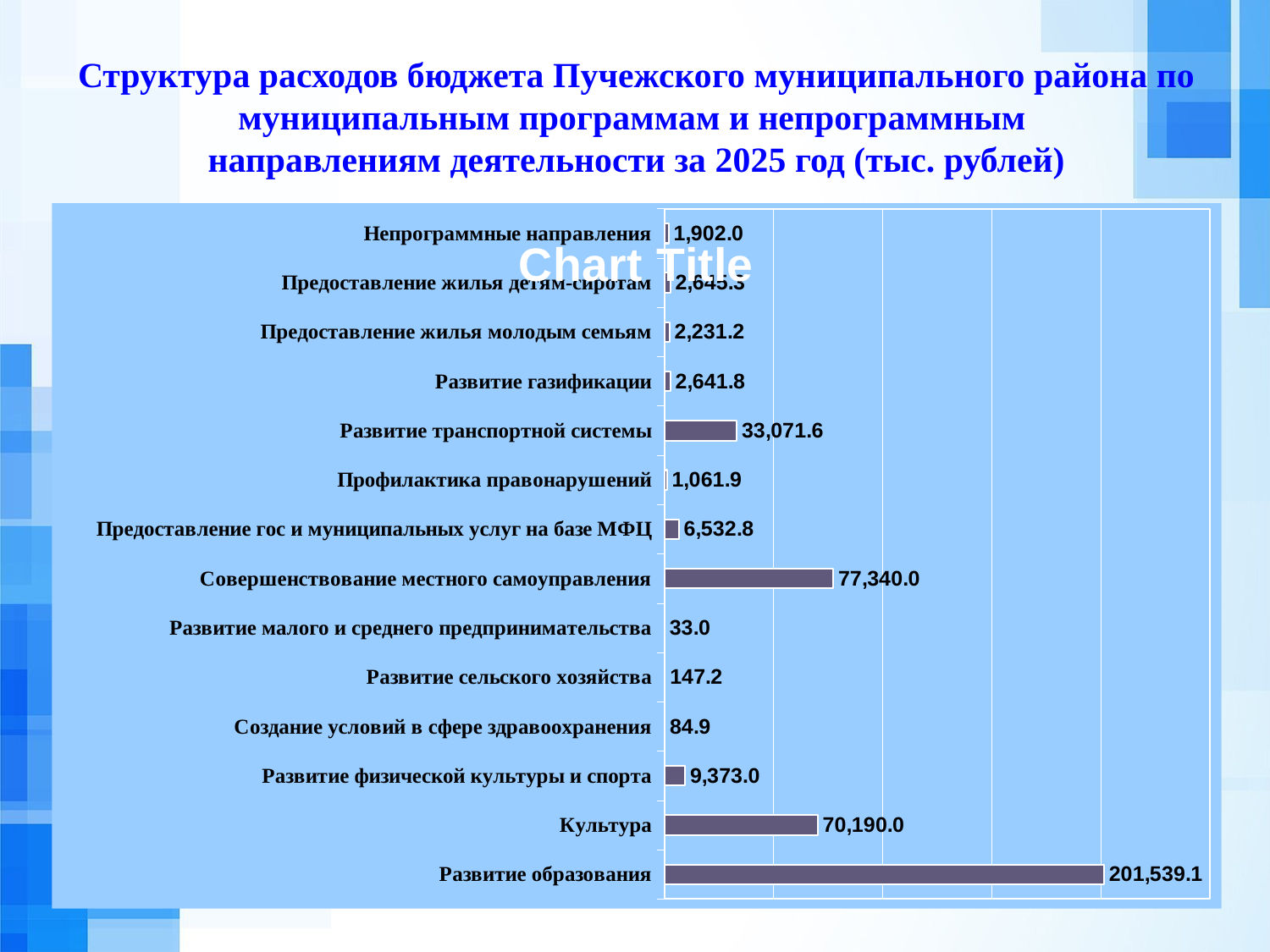
What is the difference between Развитие транспортной системы and Развитие физической культуры и спорта? 23,698.6 What is the value for Культура? 70,190.0 What is the value for Развитие транспортной системы? 33,071.6 What is the difference between Совершенствование местного самоуправления and Культура? 7,150.0 What is the value for Предоставление гос и муниципальных услуг на базе МФЦ? 6,532.8 Which category has the highest value? Развитие образования Which category has the lowest value? Развитие малого и среднего предпринимательства How many categories are shown in the chart? 14 What is the value for Развитие сельского хозяйства? 147.2 What is the value for Развитие образования? 201,539.1 What kind of chart is shown on the slide? Bar chart Which is larger: Культура or Совершенствование местного самоуправления? Совершенствование местного самоуправления